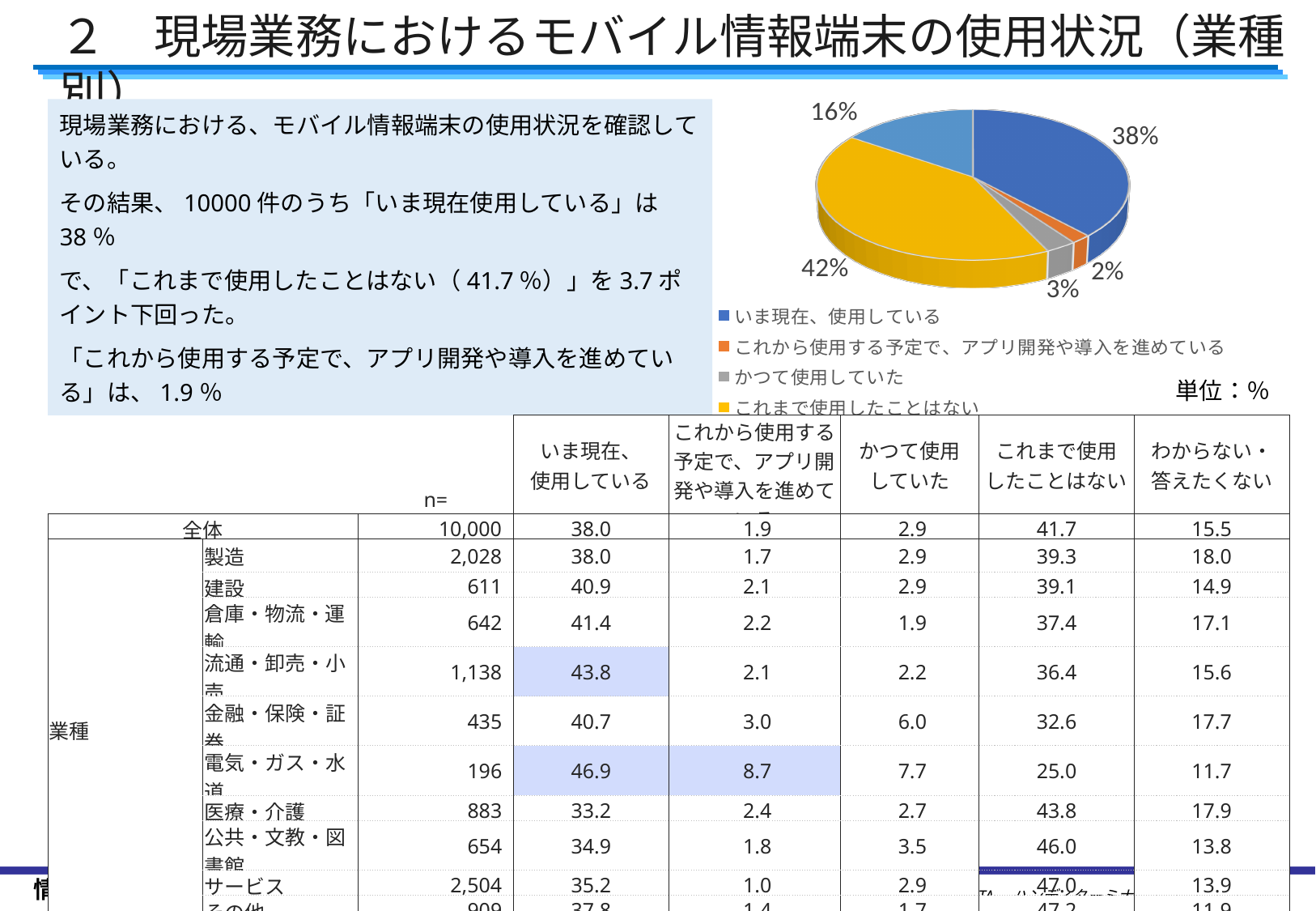
What kind of chart is shown on the slide? pie chart What is the difference between the 「いま現在、使用している」 slice and the 「かつて使用していた」 slice in the pie chart? 35% What percentage does the pie chart show for 「これまで使用したことはない」? 42% Which category has the largest slice in the pie chart? これまで使用したことはない Which category has the smallest slice in the pie chart? これから使用する予定で、アプリ開発や導入を進めている How many slices does the pie chart have? 5 What percentage does the pie chart show for 「かつて使用していた」? 3% What percentage does the pie chart show for 「いま現在、使用している」? 38% By how many percentage points does 「これまで使用したことはない」 exceed 「いま現在、使用している」 according to the pie chart labels? 4% What colour is the 「いま現在、使用している」 slice in the pie chart? blue Which is larger in the pie chart: 「いま現在、使用している」 or 「これまで使用したことはない」? これまで使用したことはない What percentage does the pie chart show for 「これから使用する予定で、アプリ開発や導入を進めている」? 2%